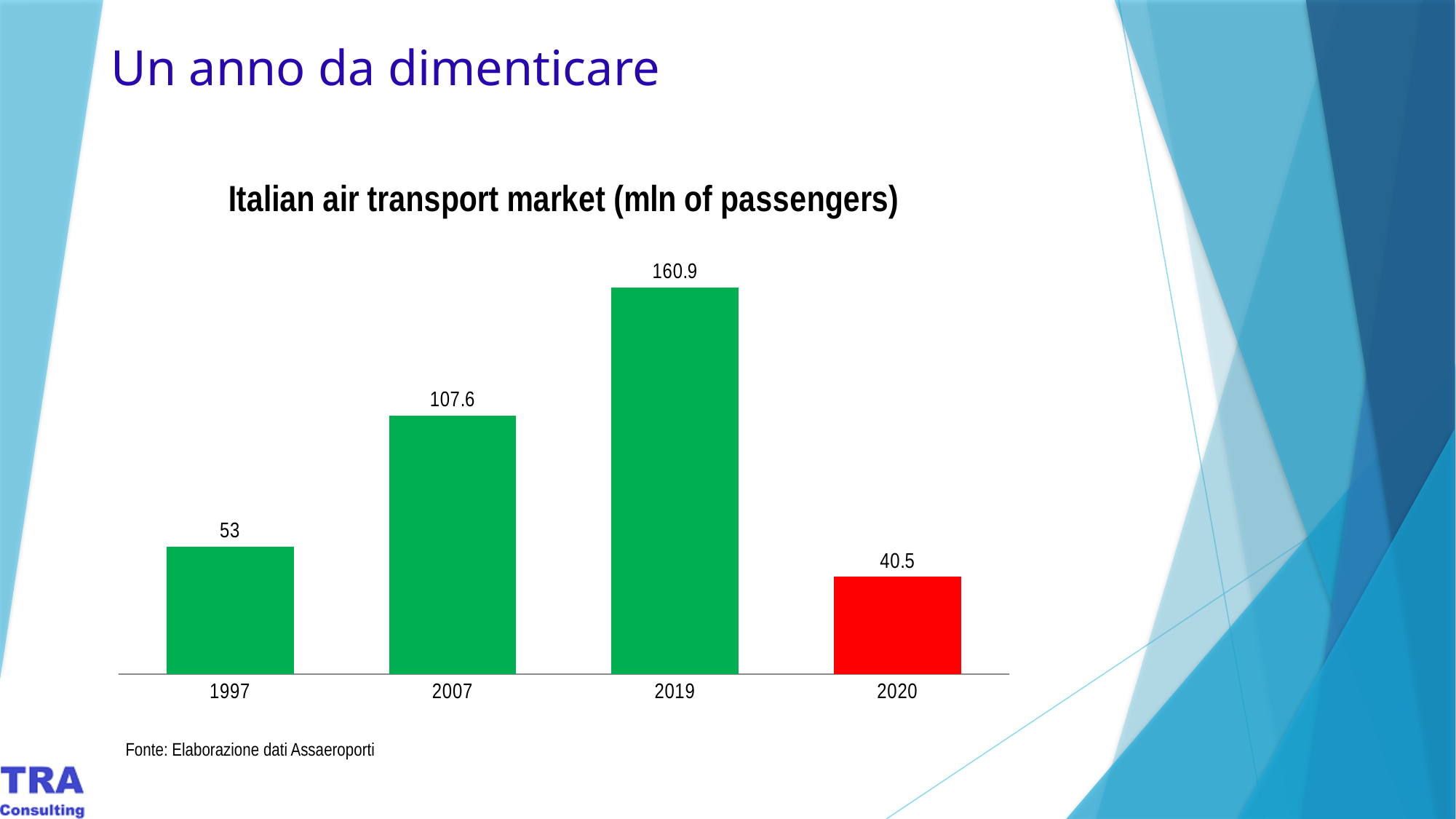
What is the value for 1997? 53 What kind of chart is shown on the slide? Bar chart Which year has the lowest value? 2020 What is the difference between the values for 2007 and 1997? 54.6 What is the difference between the values for 2019 and 2020? 120.4 What is the title of the chart? Italian air transport market (mln of passengers) What is the value for 2019? 160.9 What is the value for 2020? 40.5 What is the value for 2007? 107.6 Which is larger, the value for 1997 or the value for 2020? 1997 How many years are shown on the chart? 4 Which year has the highest value? 2019